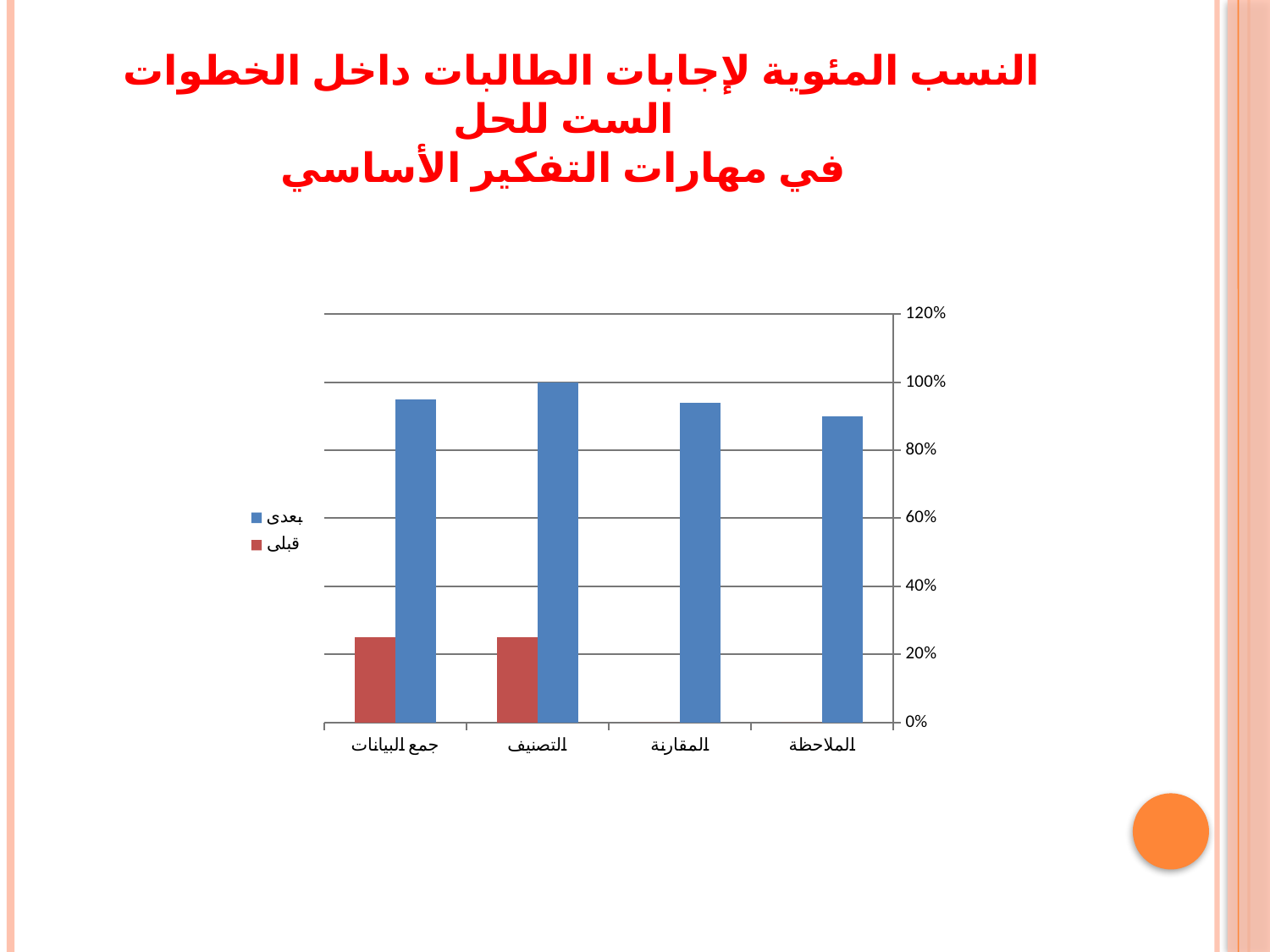
How many series does the chart's legend list? 2 Is the قبلي value for جمع البيانات greater or less than 40%? less How many categories are shown on the x axis of the chart? 4 Which colour represents the بعدي series in the chart? blue Is the بعدي value for الملاحظة greater or less than 80%? greater Which is larger: the بعدي value for التصنيف or the بعدي value for الملاحظة? التصنيف What kind of chart is shown on the slide? bar chart Is the قبلي value for التصنيف greater or less than 20%? greater Which series is shown in red in the chart? قبلي Which category has the highest value in the بعدي series? التصنيف What is the value of the بعدي series for التصنيف? 100%